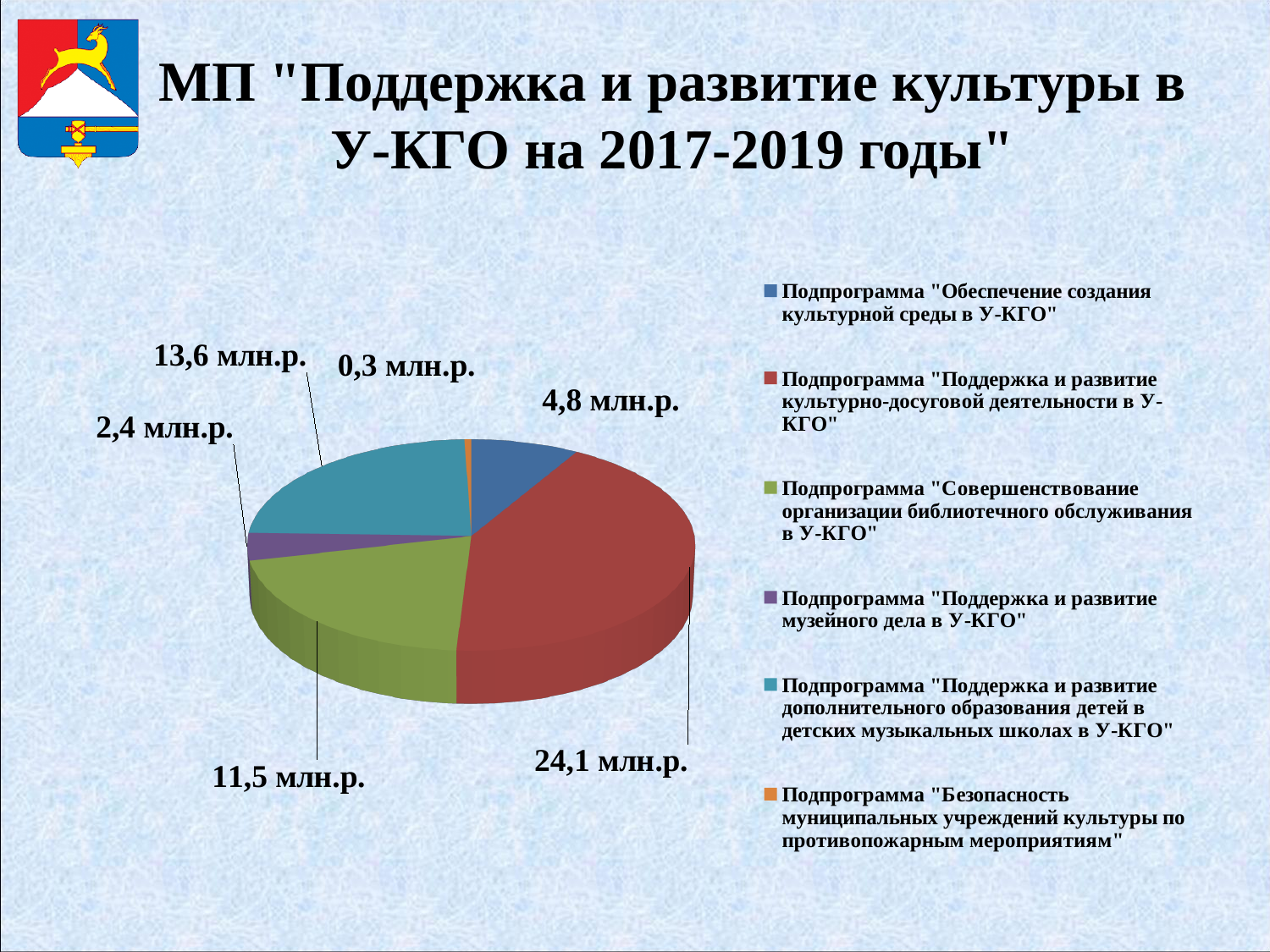
What is the value for Подпрограмма "Поддержка и развитие культурно-досуговой деятельности в У-КГО"? 24,1 млн.р. What type of chart is shown on the slide? pie chart What is the value for Подпрограмма "Совершенствование организации библиотечного обслуживания в У-КГО"? 11,5 млн.р. How many entries does the legend list? 6 What is the value for Подпрограмма "Безопасность муниципальных учреждений культуры по противопожарным мероприятиям"? 0,3 млн.р. What colour is the slice for Подпрограмма "Совершенствование организации библиотечного обслуживания в У-КГО"? green Which subprogram has the smallest slice of the pie? Подпрограмма "Безопасность муниципальных учреждений культуры по противопожарным мероприятиям" What is the value for Подпрограмма "Поддержка и развитие музейного дела в У-КГО"? 2,4 млн.р. Which is larger: the value for Подпрограмма "Обеспечение создания культурной среды в У-КГО" or the value for Подпрограмма "Поддержка и развитие музейного дела в У-КГО"? Подпрограмма "Обеспечение создания культурной среды в У-КГО" What is the difference between the value for Подпрограмма "Поддержка и развитие культурно-досуговой деятельности в У-КГО" and the value for Подпрограмма "Поддержка и развитие дополнительного образования детей в детских музыкальных школах в У-КГО"? 10,5 млн.р. How many slices does the pie chart have? 6 Which subprogram has the largest slice of the pie? Подпрограмма "Поддержка и развитие культурно-досуговой деятельности в У-КГО"